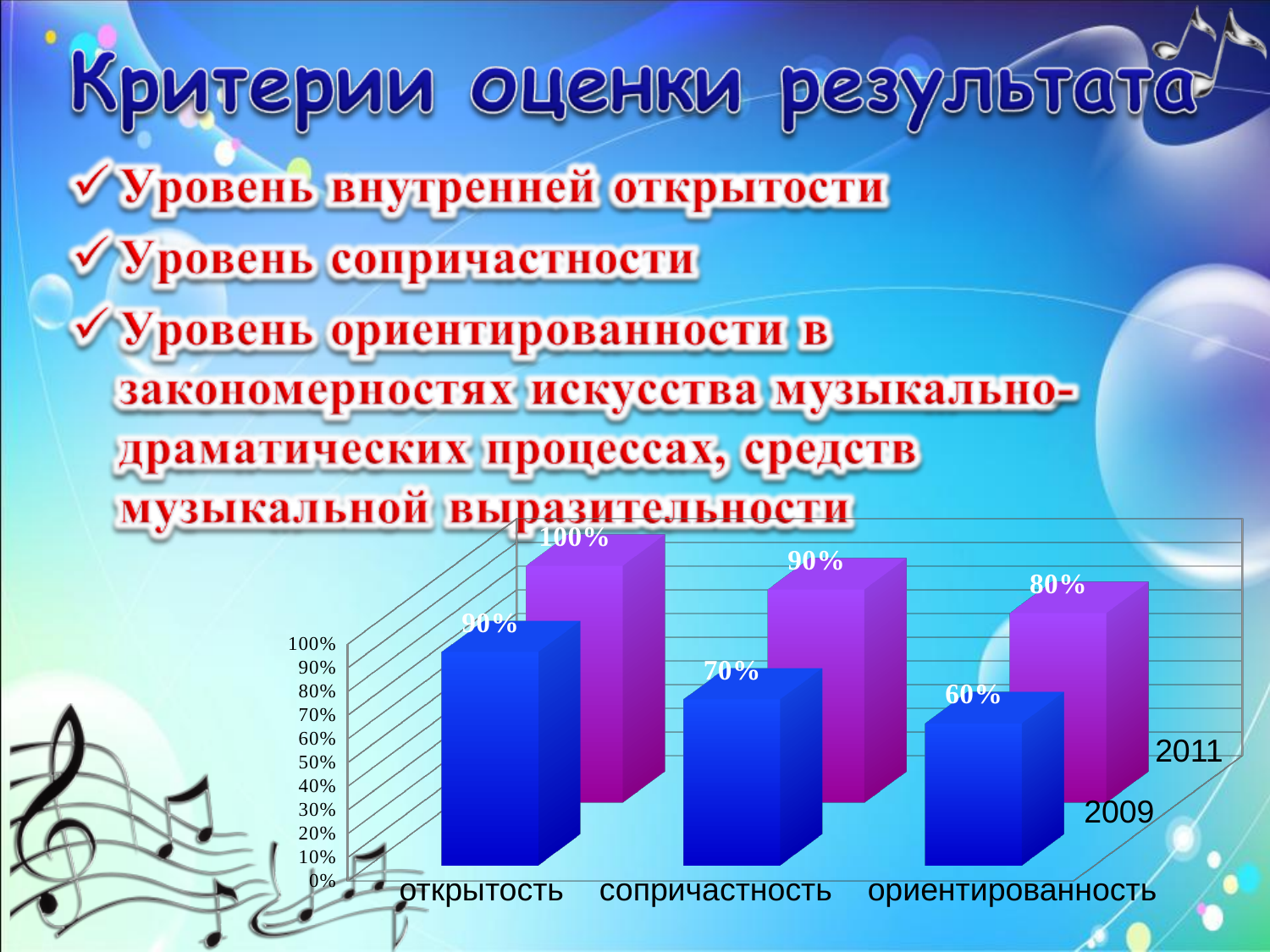
How many categories are shown on the x axis of the chart? 3 What is the value for сопричастность in 2011? 90% How many data series (years) does the chart show? 2 Which category has the highest value in 2011? открытость What is the value for открытость in 2009? 90% Do the 2009 values rise or fall from открытость to ориентированность? fall Which category has the lowest value in 2009? ориентированность What is the difference between the 2011 and 2009 values for сопричастность? 20% What is the value for ориентированность in 2011? 80% Which is larger: the 2009 value for открытость or the 2011 value for ориентированность? 2009 value for открытость What is the value for ориентированность in 2009? 60% What kind of chart is shown on the slide? bar chart